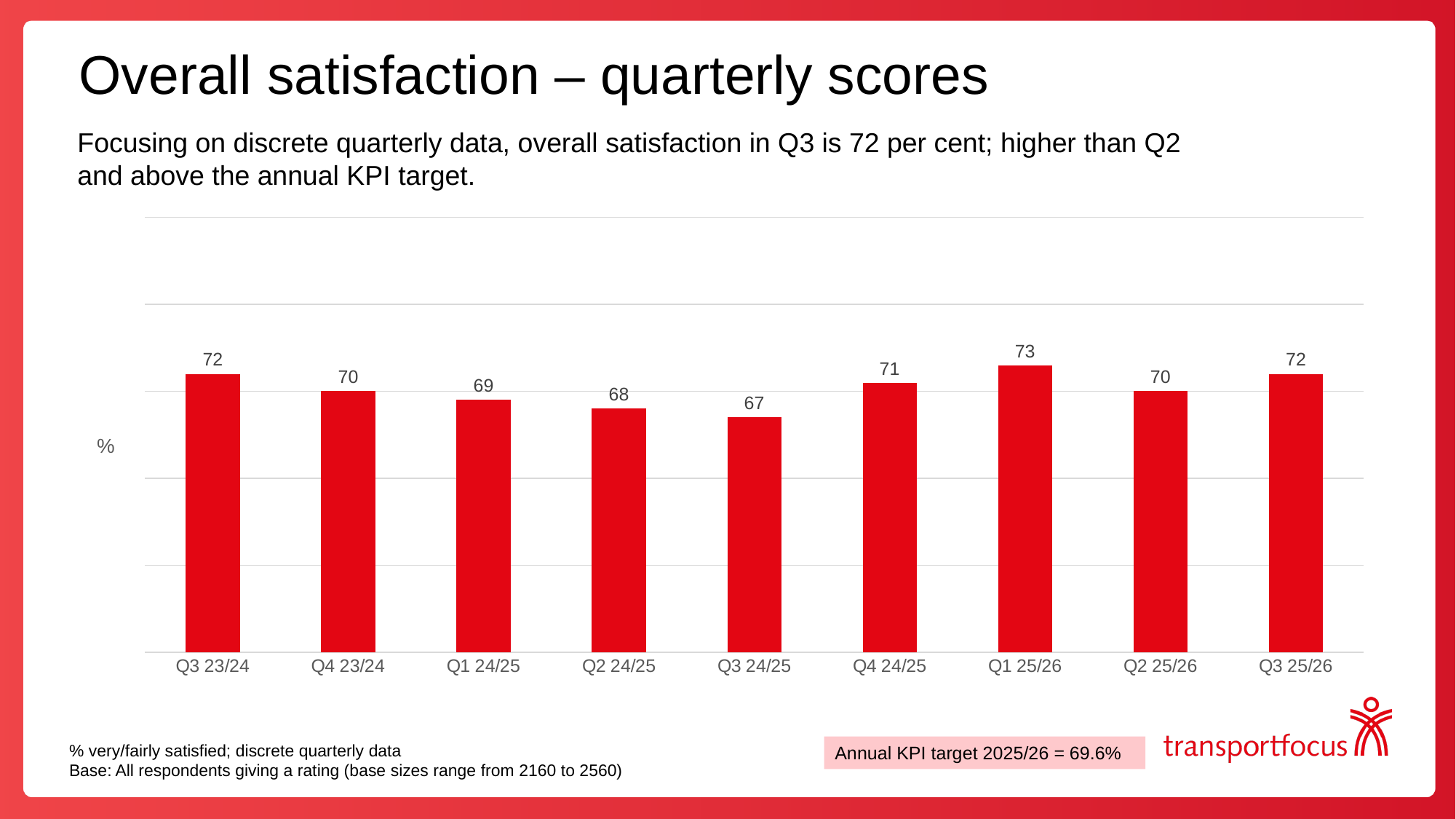
What is the annual KPI target for 2025/26 shown on the slide? 69.6% What is the difference between the scores for Q3 25/26 and Q2 25/26? 2 Which quarter has the highest overall satisfaction score? Q1 25/26 Which is higher, the score for Q4 24/25 or the score for Q1 24/25? Q4 24/25 How many quarters are shown on the chart? 9 What is the overall satisfaction score for Q3 25/26? 72 Do the scores rise or fall from Q3 23/24 to Q3 24/25? Fall What is the difference between the scores for Q1 25/26 and Q3 24/25? 6 What is the overall satisfaction score for Q2 24/25? 68 What is the overall satisfaction score for Q3 24/25? 67 What kind of chart is shown on the slide? Bar chart Which quarter has the lowest overall satisfaction score? Q3 24/25